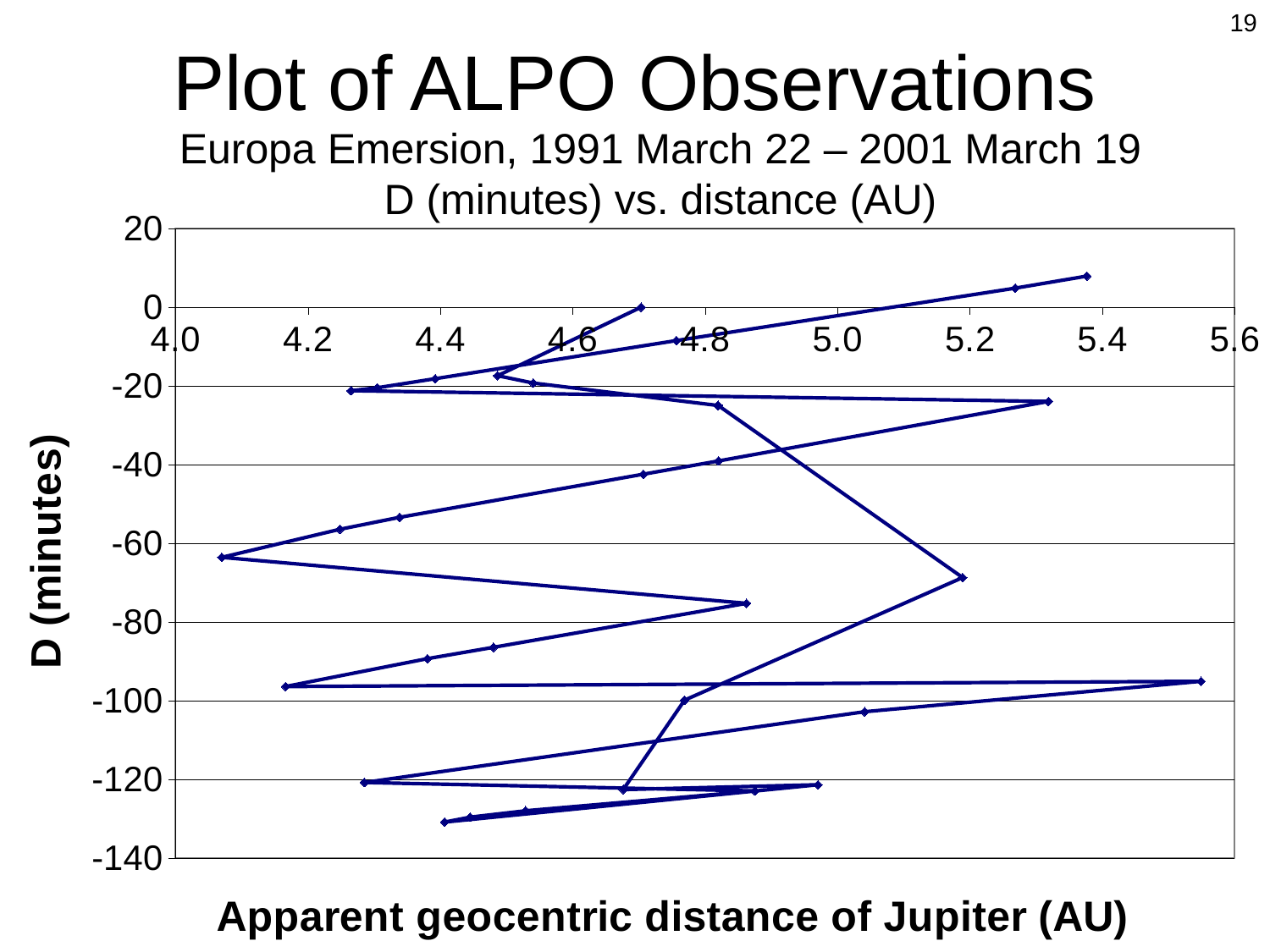
Is the smallest apparent geocentric distance plotted greater or less than 4.2? less Is the highest D value plotted greater or less than 0? greater Is the D value of the point at the far left of the chart (smallest distance) greater or less than -80? greater What is the title of the horizontal axis? Apparent geocentric distance of Jupiter (AU) What is the title of the vertical axis? D (minutes) What kind of chart is shown on the slide? line chart